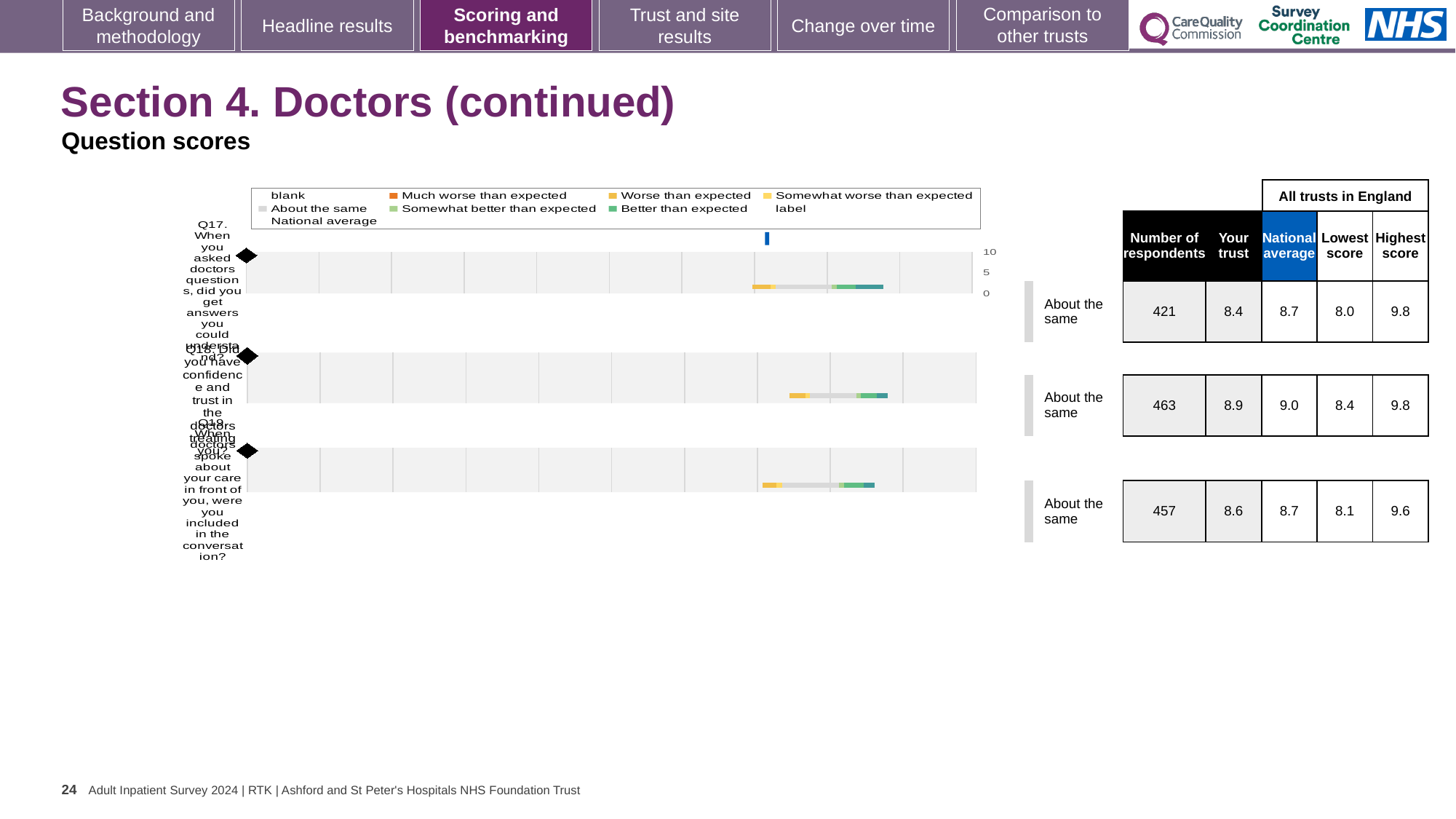
For Q17, which is larger: the 'Your trust' score or the national average? National average What is the difference between the national average and the 'Your trust' score for Q18? 0.1 What is the 'Your trust' score for Q17? 8.4 What is the national average score for Q18? 9.0 Which question has the lowest 'Your trust' score? Q17 Which question has the highest 'Your trust' score? Q18 What kind of chart is used to show the question scores for Q17, Q18 and Q19? bar chart What benchmark category is shown next to the Q17 chart? About the same What is the highest score among all trusts in England for Q19? 9.6 How many respondents answered Q19? 457 How many questions are plotted on the slide? 3